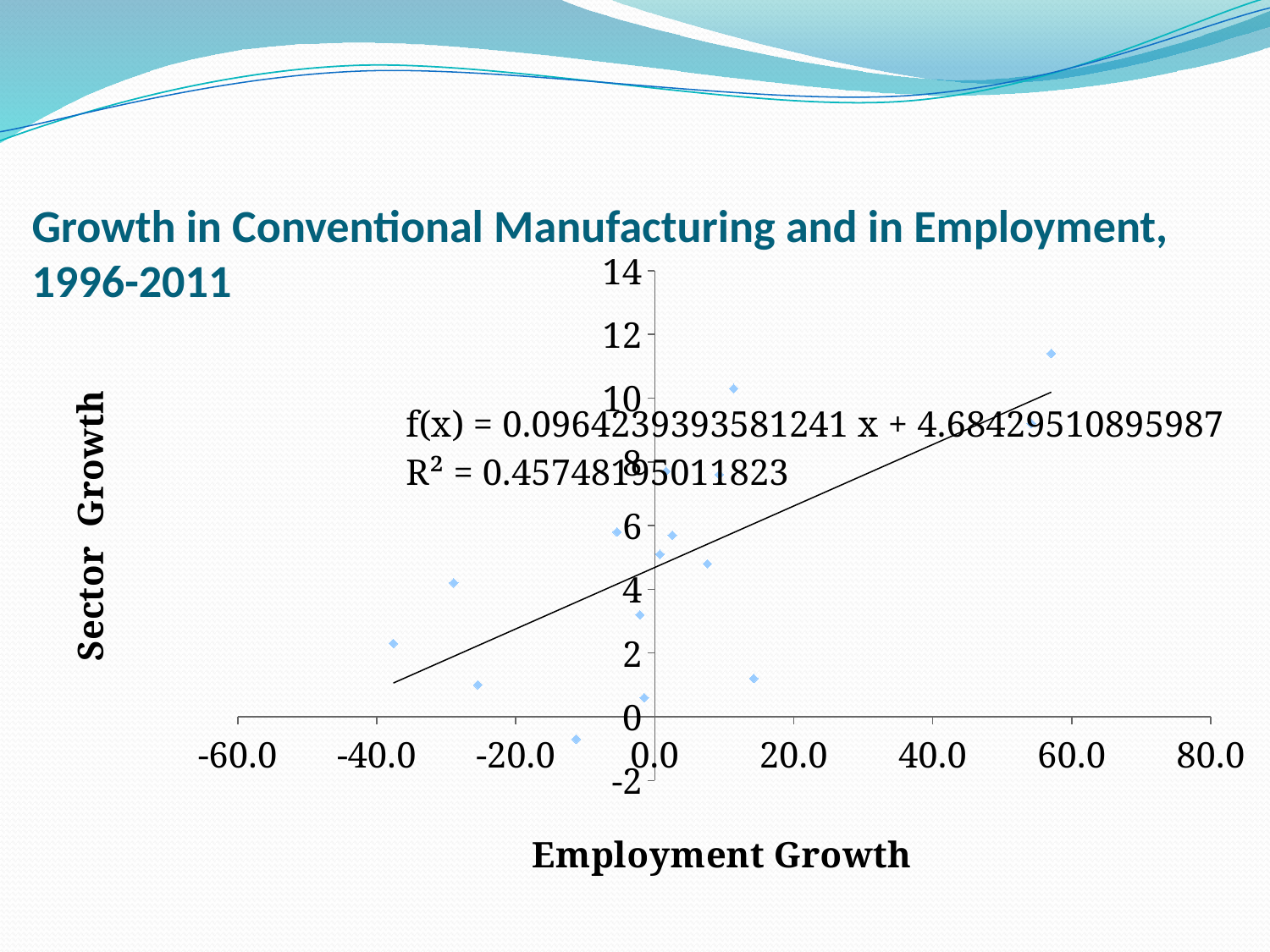
Is the Sector Growth value of the lowest point greater or less than 0? less Is the Employment Growth value of the leftmost point greater or less than -20.0? less What is the title of the chart? Growth in Conventional Manufacturing and in Employment, 1996-2011 Does the trendline rise or fall as Employment Growth increases? rise What kind of chart is shown on the slide? scatter chart What is the highest tick value shown on the vertical axis? 14 Is the Sector Growth value of the rightmost point greater or less than 10? greater What is the R² value printed on the chart? 0.457481950011823 What is the highest tick value shown on the horizontal axis? 80.0 What is the label of the horizontal axis? Employment Growth What is the trendline equation printed on the chart? f(x) = 0.0964239393581241 x + 4.68429510895987